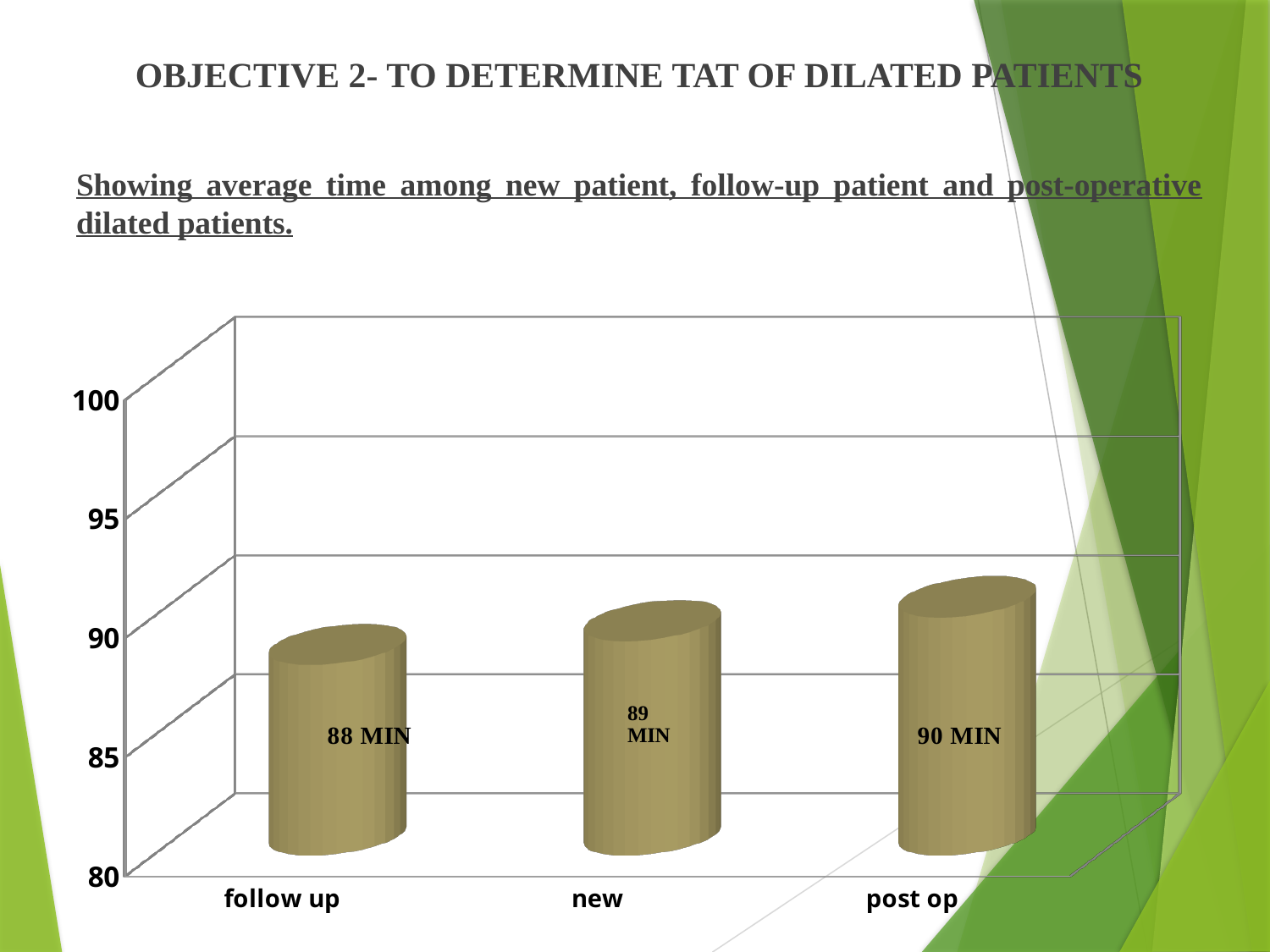
What is the difference between the values for new and follow up? 1 MIN Is the value for follow up greater or less than 95? less What is the difference between the values for post op and follow up? 2 MIN What kind of chart is shown on the slide? bar chart How many categories are shown on the x axis? 3 Which category has the highest value? post op Which category has the lowest value? follow up Do the values rise or fall from follow up to post op along the x axis? rise Which is larger, the value for post op or the value for new? post op What is the value for follow up? 88 MIN What is the value for new? 89 MIN What is the value for post op? 90 MIN